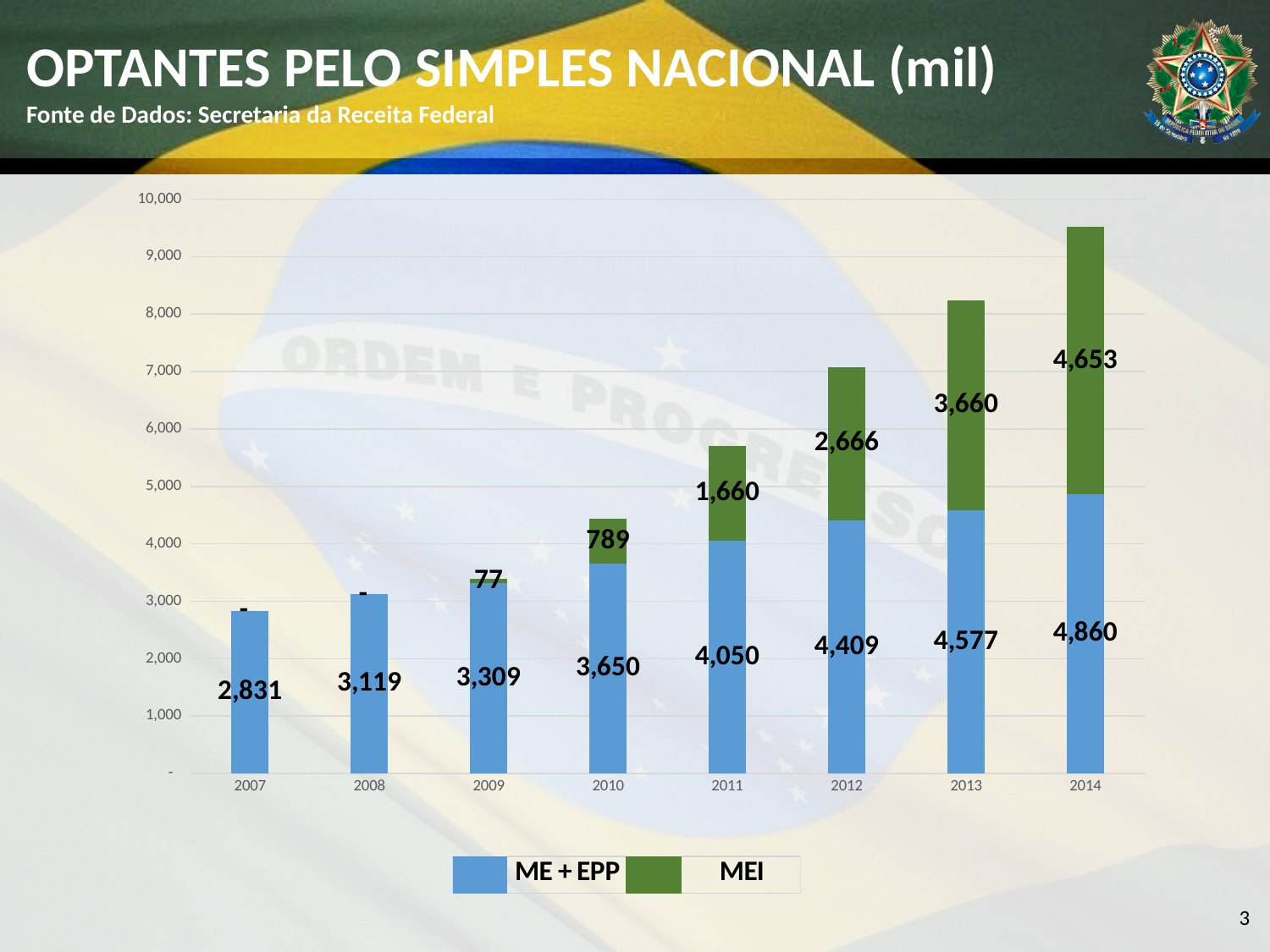
What is the MEI value for 2009? 77 What is the ME + EPP value for 2007? 2,831 Which year has the lowest ME + EPP value? 2007 Which is larger in 2013, the ME + EPP value or the MEI value? ME + EPP What is the ME + EPP value for 2014? 4,860 Which year has the highest MEI value? 2014 How many years are shown on the x axis? 8 What type of chart is shown on the slide? stacked bar chart What is the difference between the ME + EPP values for 2014 and 2013? 283 What is the MEI value for 2012? 2,666 What is the total of the stacked bar for 2014? 9,513 How many series does the legend list? 2